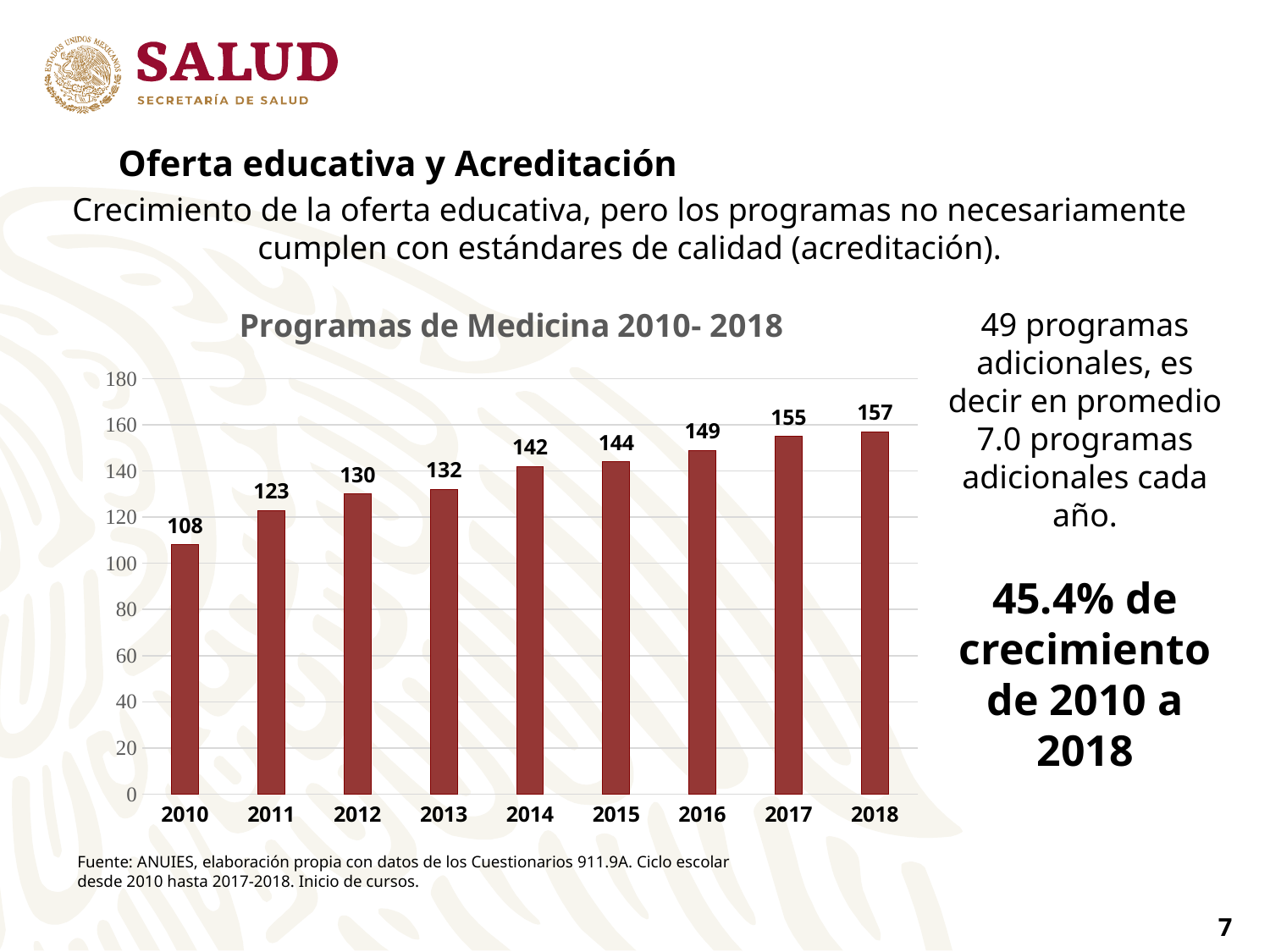
Which year has the lowest value? 2010 Which is larger, the value for 2013 or the value for 2015? 2015 Do the values rise or fall from 2010 to 2018? rise What is the difference between the values for 2018 and 2010? 49 What is the value for 2014? 142 Is the value for 2016 greater or less than 140? greater Which year has the highest value? 2018 How many years are shown on the x axis? 9 What is the value for 2017? 155 What is the difference between the values for 2012 and 2011? 7 What kind of chart is shown on the slide? bar chart What is the value for 2010? 108